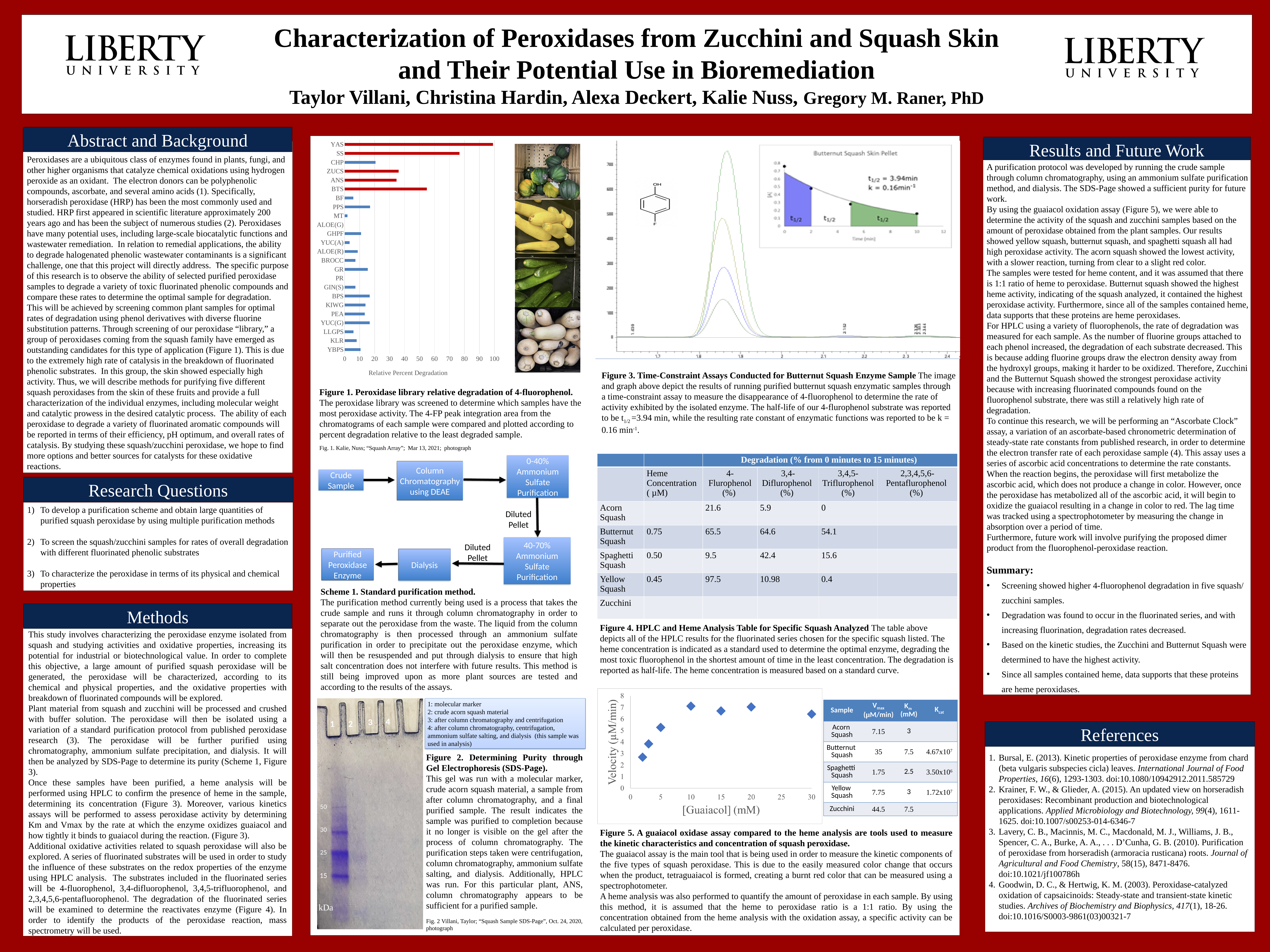
In the Figure 5 scatter plot, does velocity rise or fall as guaiacol concentration increases from 0 to 10 mM? rise In the Figure 1 bar chart, is the value for CHP greater or less than 30? less How many samples (bars) are plotted in the Figure 1 bar chart? 22 What kind of chart is the Figure 5 guaiacol oxidase assay plot? Scatter plot In the Figure 1 bar chart, is the value for YAS greater or less than 90? greater What is the x-axis label of the Figure 1 bar chart? Relative Percent Degradation In the Figure 1 bar chart, which sample has the highest relative percent degradation? YAS What kind of chart is Figure 1 (Peroxidase library relative degradation of 4-fluorophenol)? Bar chart In the Figure 1 bar chart, how many bars are coloured red? 5 How many data points are plotted in the Figure 5 scatter plot? 7 In the Figure 1 bar chart, which has the larger relative percent degradation, BTS or ZUCS? BTS In the Figure 5 scatter plot, is the velocity at 10 mM guaiacol greater or less than 6 µM/min? greater